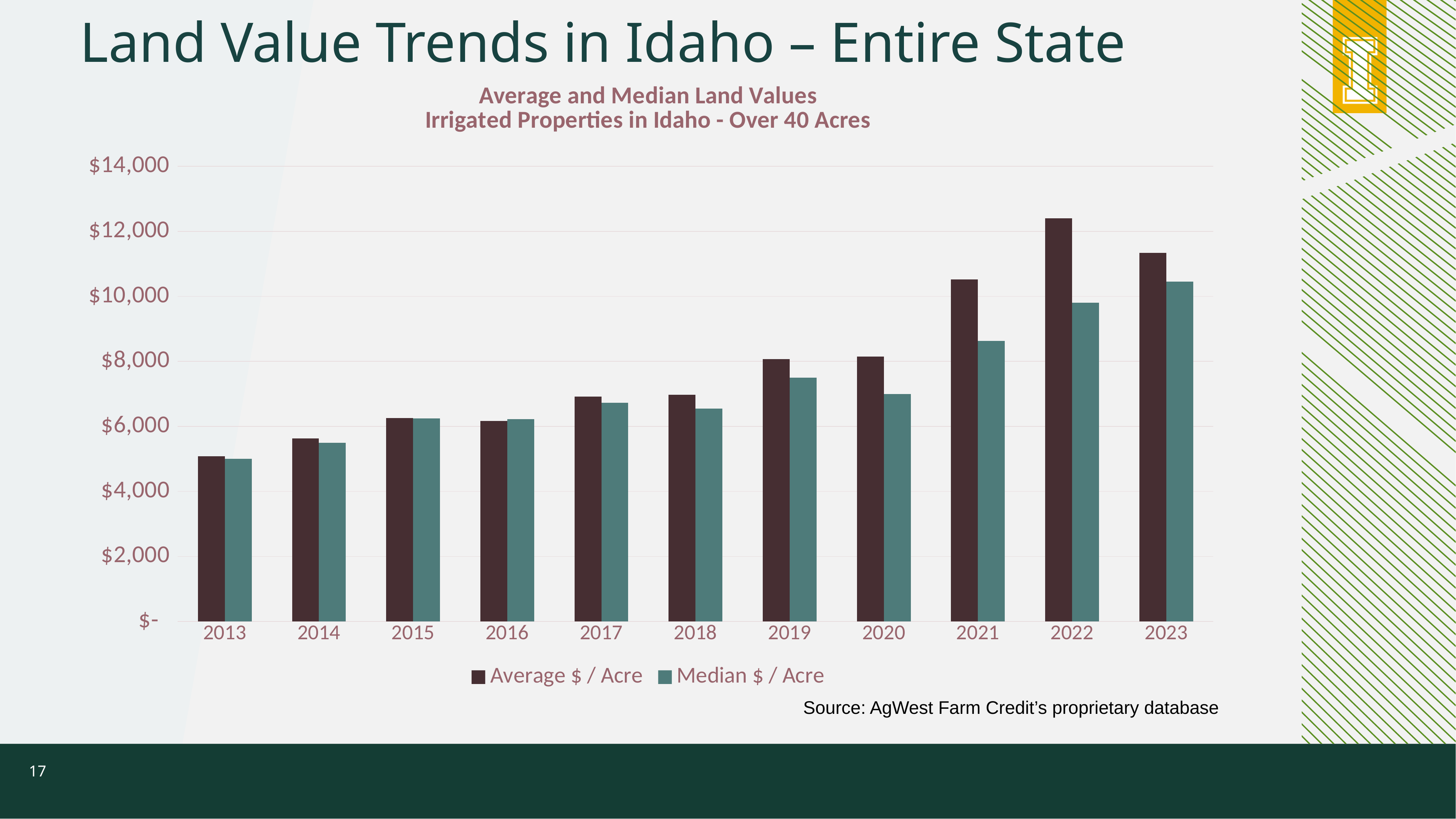
How many series does the legend list? 2 Is the Average $ / Acre for 2022 greater or less than $12,000? greater Which year has the lowest Average $ / Acre? 2013 Is the Average $ / Acre for 2013 greater or less than $6,000? less Which year has the highest Average $ / Acre? 2022 Do the Average $ / Acre values generally rise or fall from 2013 to 2022? Rise Is the Median $ / Acre for 2019 greater or less than $8,000? less What kind of chart is shown on the slide? Bar chart How many years are shown on the x axis? 11 What is the subtitle of the chart? Average and Median Land Values Irrigated Properties in Idaho - Over 40 Acres In 2021, which is larger: the Average $ / Acre or the Median $ / Acre? Average $ / Acre Which year has the highest Median $ / Acre? 2023